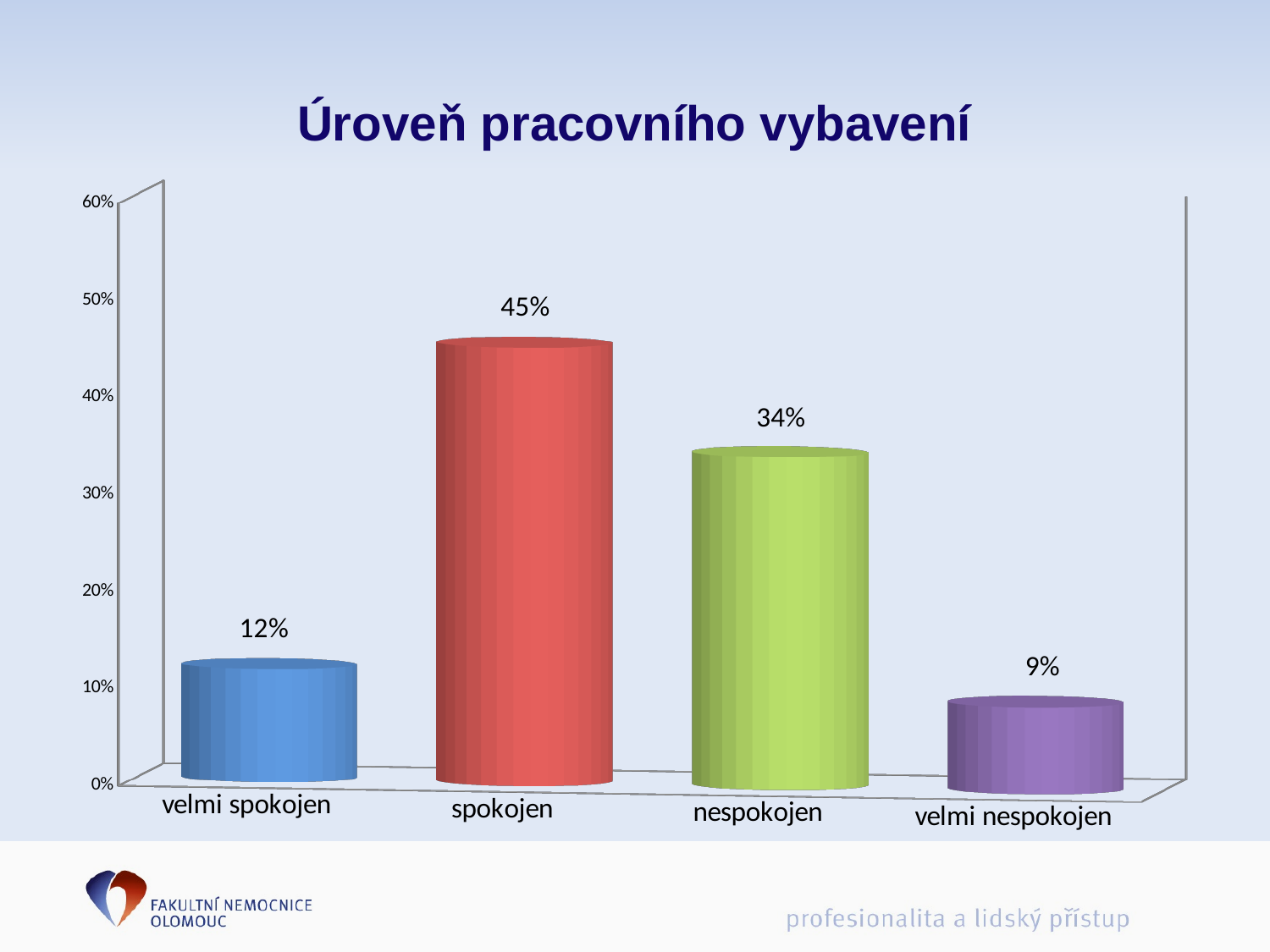
What is the value for "spokojen"? 45% Which category has the lowest value? velmi nespokojen How many categories are shown on the x axis? 4 What is the difference between the values for "spokojen" and "nespokojen"? 11% What is the value for "velmi nespokojen"? 9% Is the value for "nespokojen" greater or less than 30%? greater Which category has the highest value? spokojen What kind of chart is shown on the slide? bar chart What is the title of the chart? Úroveň pracovního vybavení What is the value for "nespokojen"? 34% What is the value for "velmi spokojen"? 12% Which is larger, the value for "velmi spokojen" or the value for "velmi nespokojen"? velmi spokojen